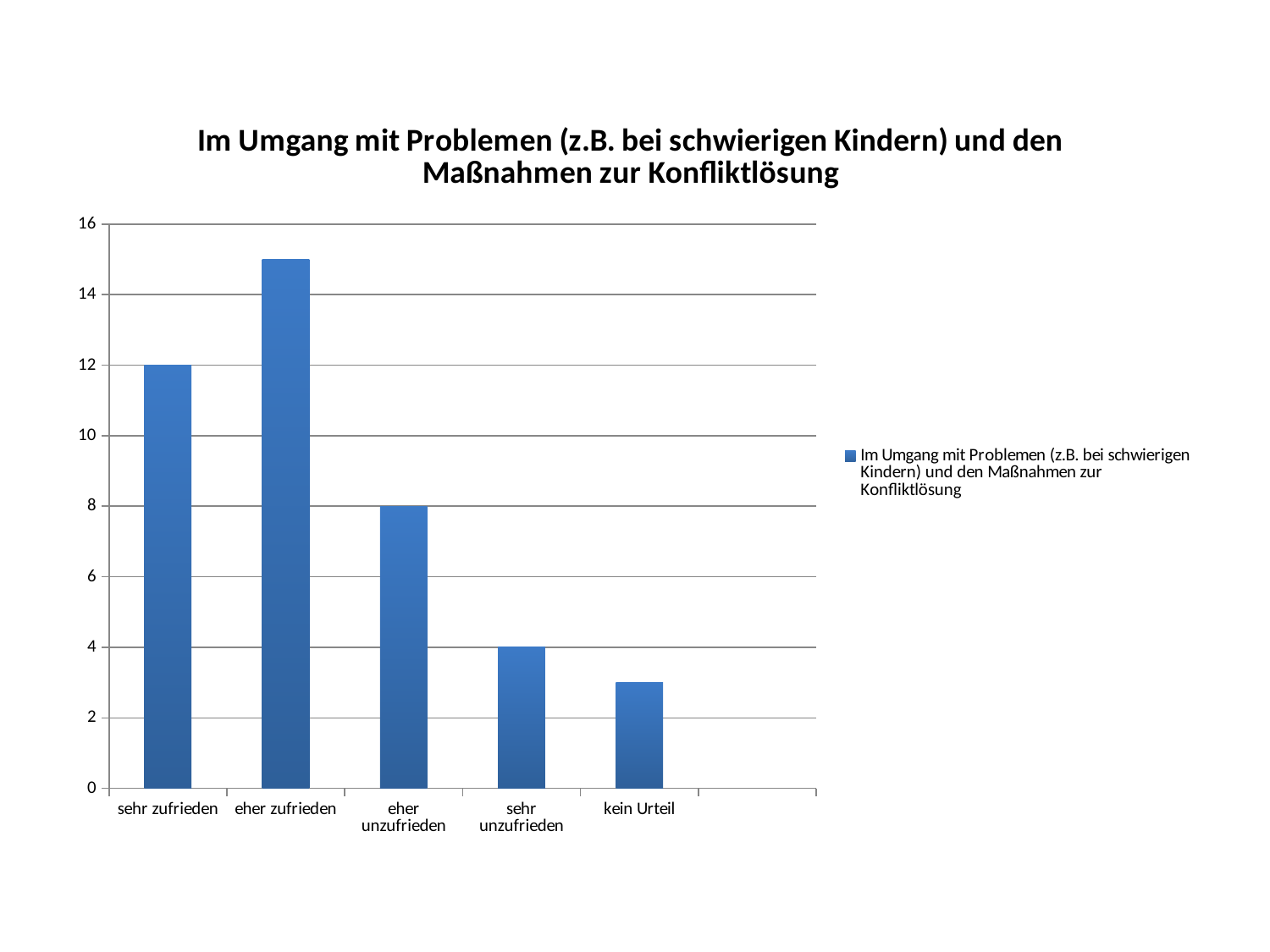
Is the value for "kein Urteil" greater or less than 4? less What is the value for "sehr zufrieden"? 12 Is the value for "eher zufrieden" greater or less than 14? greater How many series does the legend list? 1 How many categories are shown on the x axis of the chart? 5 What is the difference between the values for "sehr zufrieden" and "eher unzufrieden"? 4 Which is larger, the value for "sehr zufrieden" or the value for "sehr unzufrieden"? sehr zufrieden What is the value for "eher unzufrieden"? 8 What is the value for "sehr unzufrieden"? 4 Which category has the highest value? eher zufrieden What type of chart is shown on the slide? bar chart Which category has the lowest value? kein Urteil